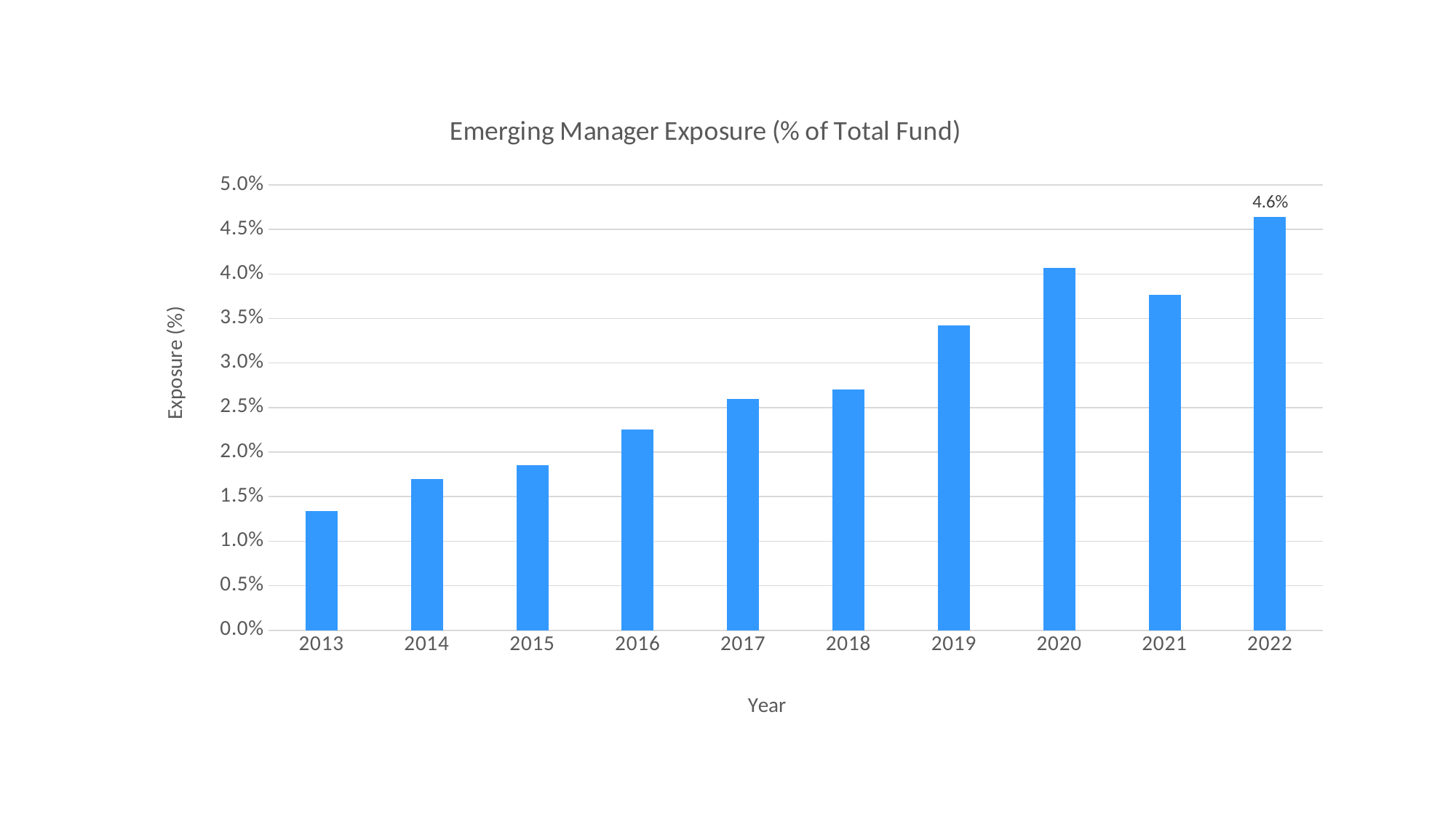
What is the emerging manager exposure for 2022? 4.6% Is the value for 2016 greater or less than 2.0%? greater Is the value for 2020 greater or less than 4.0%? greater Is the value for 2019 greater or less than 3.5%? less What kind of chart is shown on the slide? Bar chart How many years are shown on the x axis? 10 Which year has the lowest emerging manager exposure? 2013 Which year has the larger exposure, 2015 or 2017? 2017 Which year has the larger exposure, 2020 or 2021? 2020 What is the title of the chart? Emerging Manager Exposure (% of Total Fund) Which year has the highest emerging manager exposure? 2022